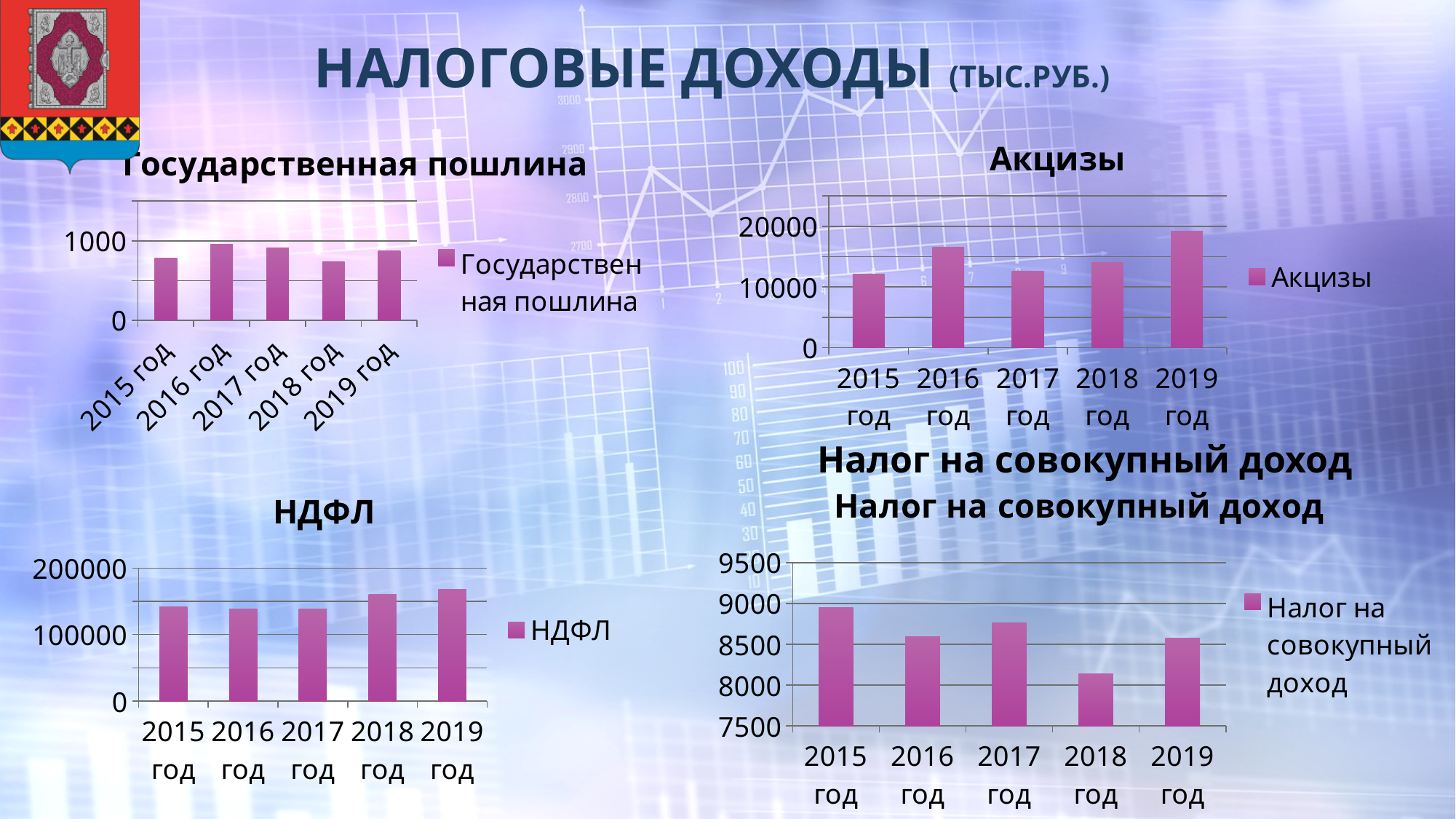
In the Акцизы chart, is the value for 2016 год greater or less than 10000? greater In the Акцизы chart, which year has the highest value? 2019 год In the Налог на совокупный доход chart, which is larger, the value for 2015 год or for 2018 год? 2015 год In the Налог на совокупный доход chart, is the value for 2018 год greater or less than 8500? less In the НДФЛ chart, which year has the highest value? 2019 год How many years are shown on the x axis of the Акцизы chart? 5 In the Государственная пошлина chart, which year has the highest value? 2016 год What is the unit given in the slide title? тыс.руб. In the Налог на совокупный доход chart, which year has the lowest value? 2018 год What kind of chart is the НДФЛ chart? bar chart In the НДФЛ chart, is the value for 2019 год greater or less than 200000? less